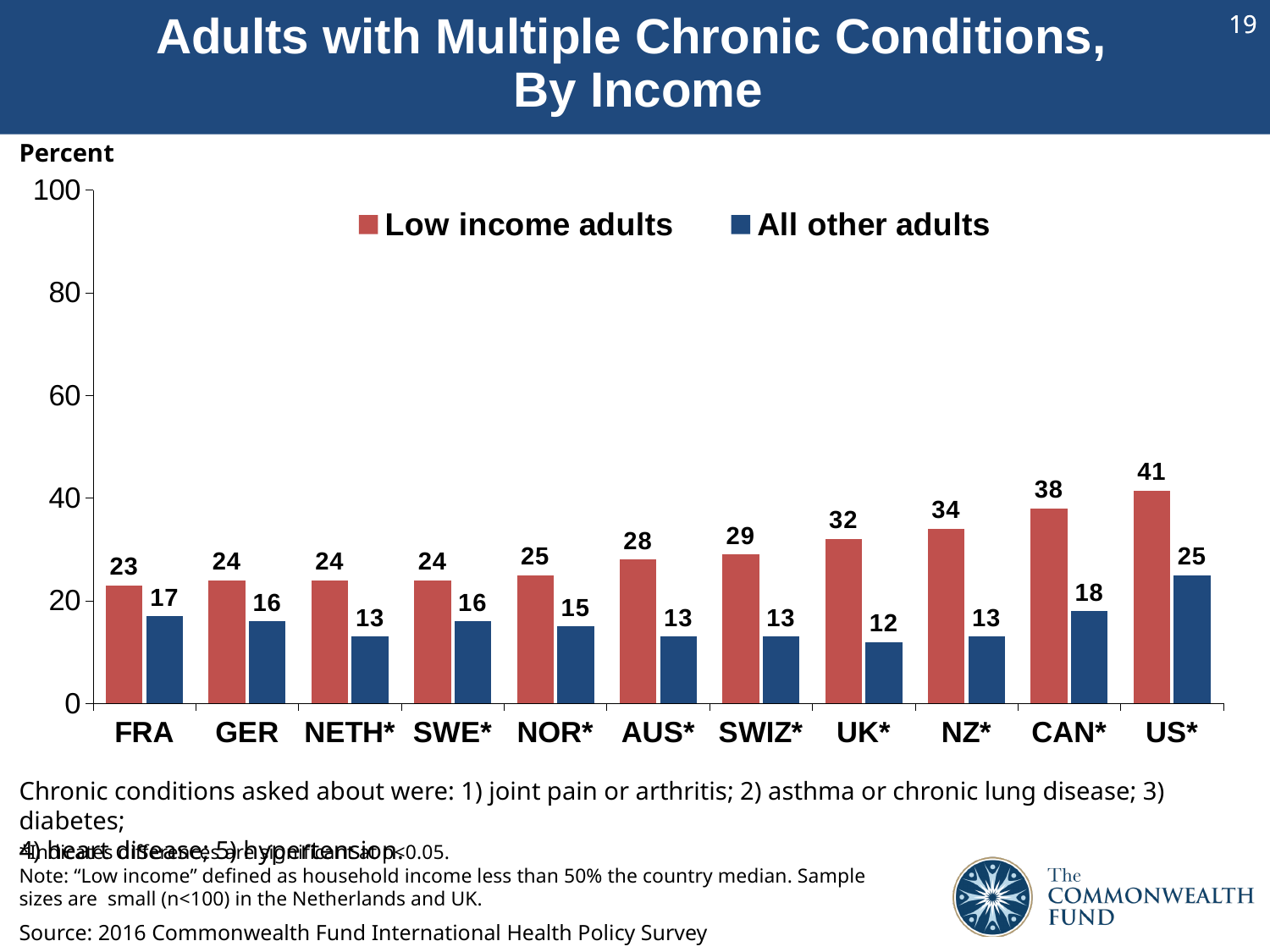
How many countries are shown on the x axis? 11 Which country has the highest value for Low income adults? US* Is the value for Low income adults in US* greater or less than 40? greater What is the difference between Low income adults and All other adults in CAN*? 20 What colour are the bars for All other adults? blue What is the value for All other adults in GER? 16 What kind of chart is shown on the slide? bar chart Which country has the lowest value for All other adults? UK* What is the value for Low income adults in US*? 41 How many series does the legend list? 2 Which is larger: the Low income adults value for NZ* or the Low income adults value for SWIZ*? NZ* Do the Low income adults values rise or fall from FRA to US* along the x axis? rise